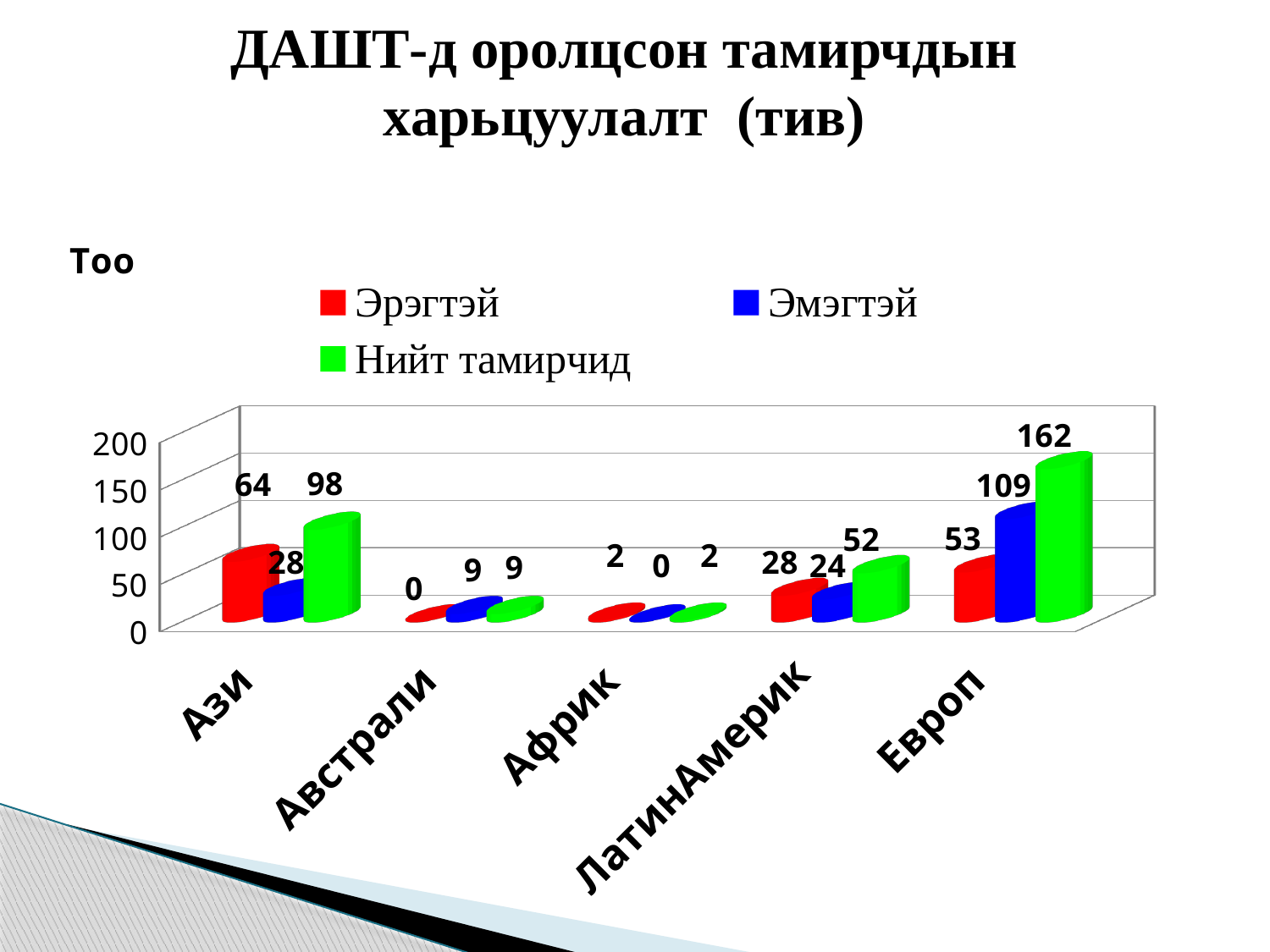
Which category has the highest value for Нийт тамирчид? Европ How many series does the legend list? 3 What is the value for Нийт тамирчид in ЛатинАмерик? 52 What kind of chart is shown on the slide? Bar chart What is the value for Эмэгтэй in Австрали? 9 What colour represents the Нийт тамирчид series? Green Which is larger in Европ: Эрэгтэй or Эмэгтэй? Эмэгтэй How many categories are shown on the x axis? 5 What is the value for Эрэгтэй in Ази? 64 What is the difference between the Нийт тамирчид values for Европ and Ази? 64 Which category has the lowest value for Нийт тамирчид? Африк What is the value for Эмэгтэй in Европ? 109